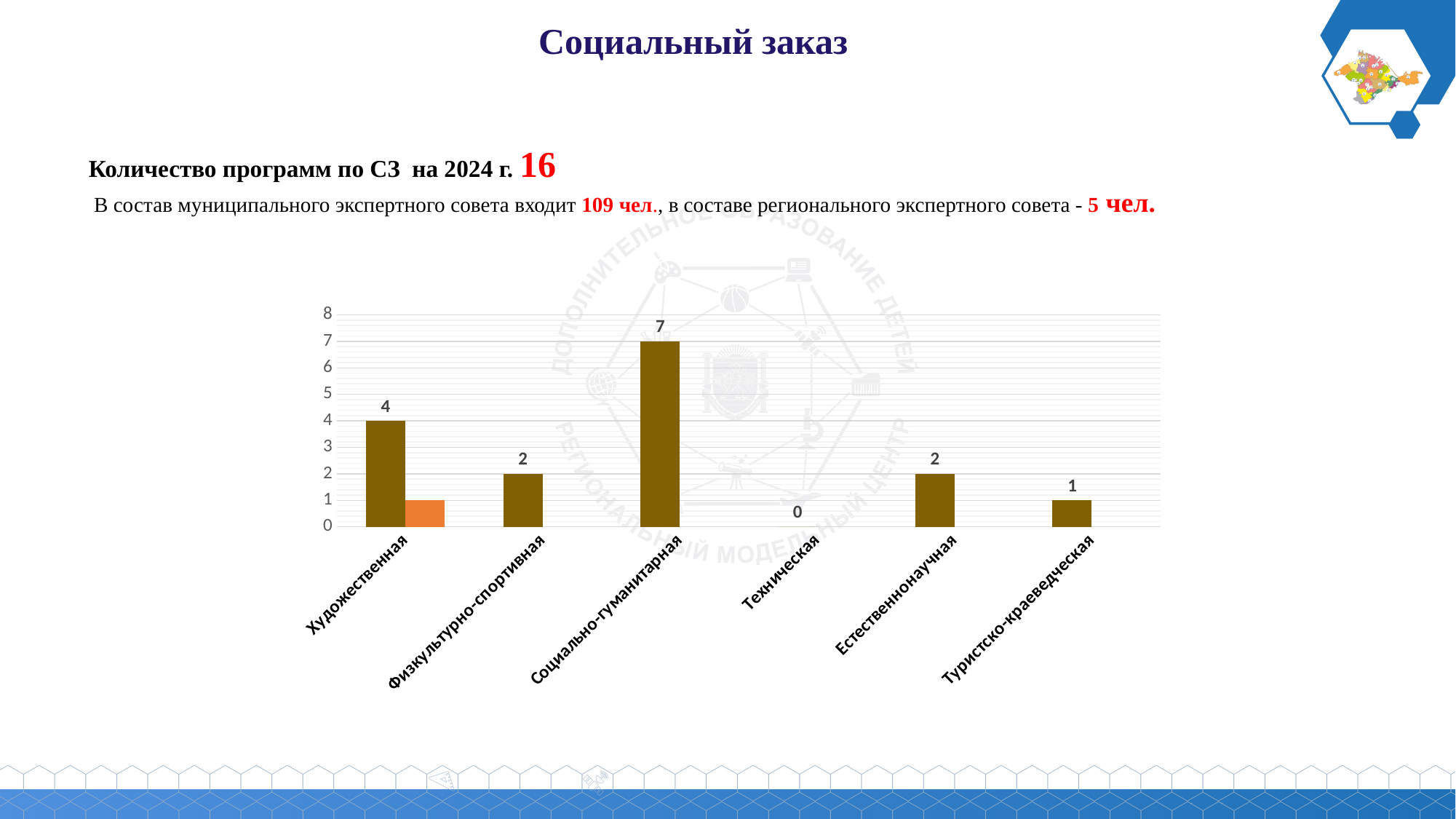
What is the value for Туристско-краеведческая? 1 Which category has the highest value? Социально-гуманитарная Which is larger, the value for Физкультурно-спортивная or the value for Туристско-краеведческая? Физкультурно-спортивная What kind of chart is shown on the slide? bar chart What is the difference between the values for Социально-гуманитарная and Художественная? 3 How many categories are shown on the x axis? 6 What is the value for Естественнонаучная? 2 Which category has the lowest value? Техническая Is the value for Социально-гуманитарная greater or less than 5? greater What is the value for Социально-гуманитарная? 7 What is the value for Техническая? 0 What is the value for Художественная (the brown bar)? 4